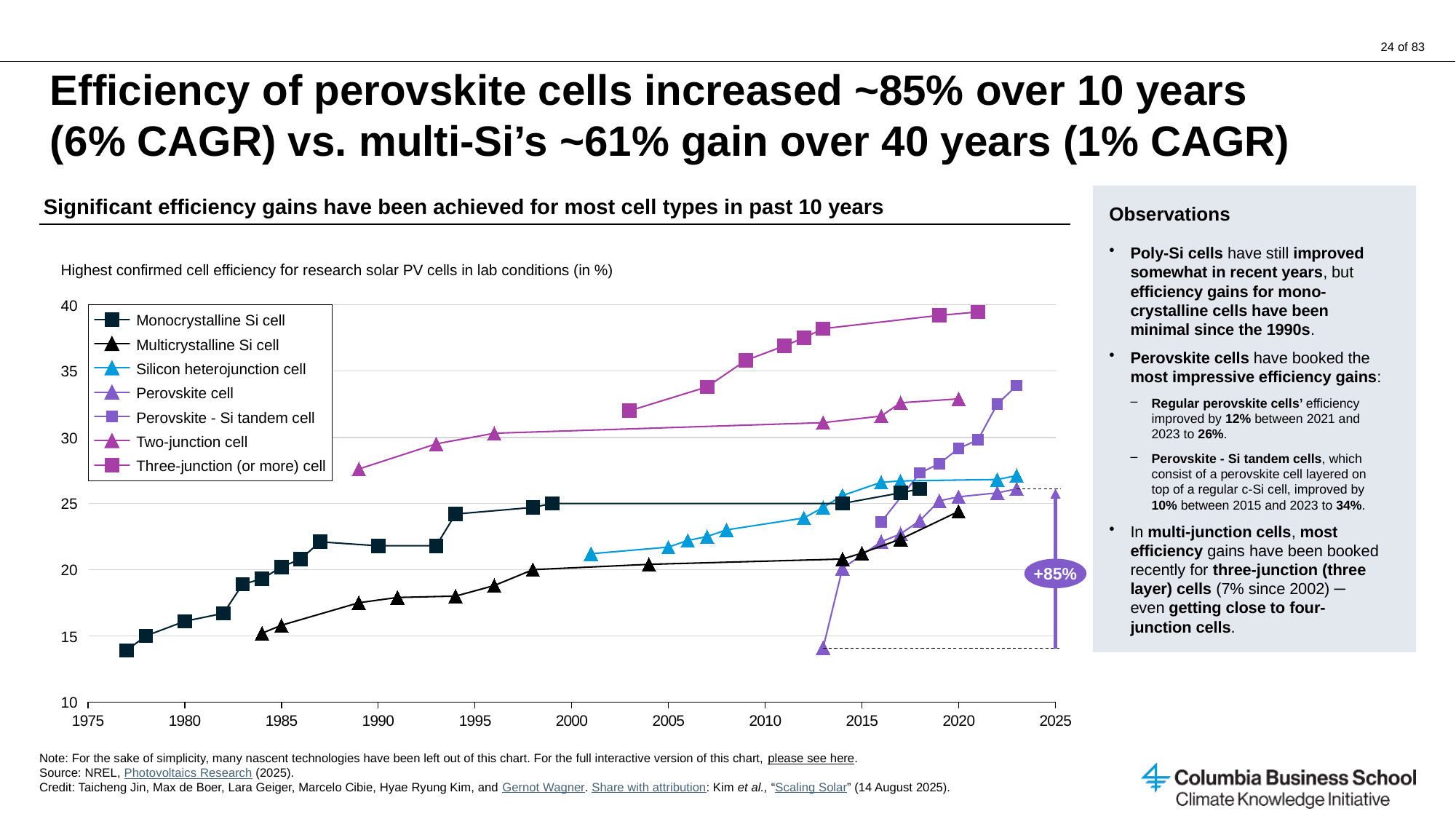
Does the efficiency of the Monocrystalline Si cell rise or fall from 1977 to 2018? Rise What kind of chart is shown on the slide? Line chart In 2023, which is higher: the Perovskite - Si tandem cell or the Perovskite cell? Perovskite - Si tandem cell Which series reaches the highest efficiency on the chart? Three-junction (or more) cell What is the highest value shown on the chart's y-axis? 40 How many series does the chart's legend list? 7 What percentage gain is shown by the annotation next to the Perovskite cell line? +85% Is the value for the Two-junction cell in 1989 greater or less than 25? greater Is the value for the Multicrystalline Si cell in 1984 greater or less than 20? less Is the value for the Three-junction (or more) cell in 2021 greater or less than 35? greater